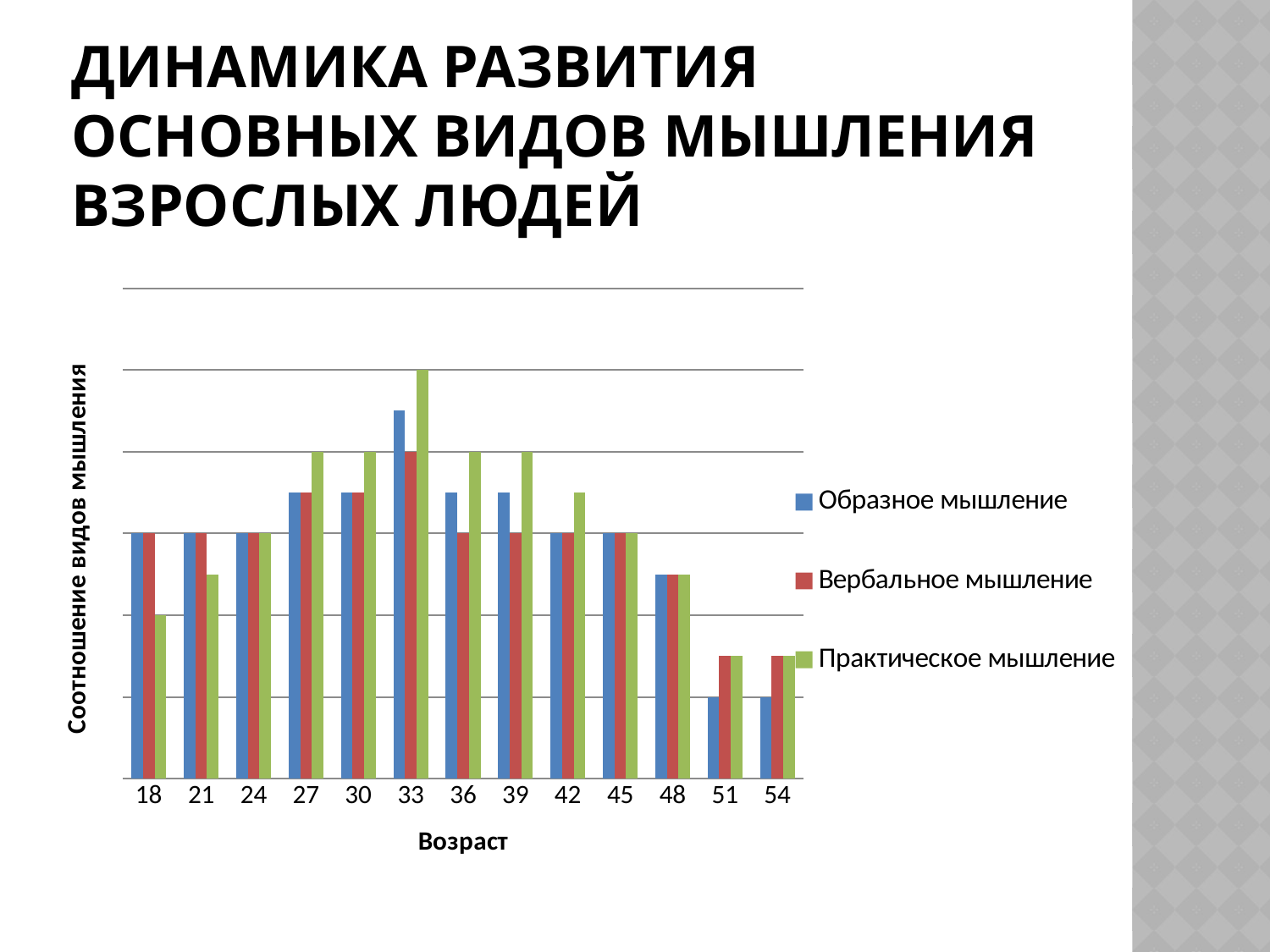
How many age categories are shown on the x axis of the chart? 13 At age 33, which is larger: Практическое мышление or Образное мышление? Практическое мышление At age 42, which is larger: Вербальное мышление or Практическое мышление? Практическое мышление At age 18, which is larger: Образное мышление or Практическое мышление? Образное мышление What is the title of the x axis of the chart? Возраст How many series does the chart's legend list? 3 Do the values for Образное мышление rise or fall from age 45 to age 54? Fall At which age is the value for Практическое мышление highest? 33 At which age is the value for Образное мышление highest? 33 What kind of chart is shown on the slide? Bar chart Which series is shown in green in the chart's legend? Практическое мышление At which age is the value for Практическое мышление lowest? 51 and 54